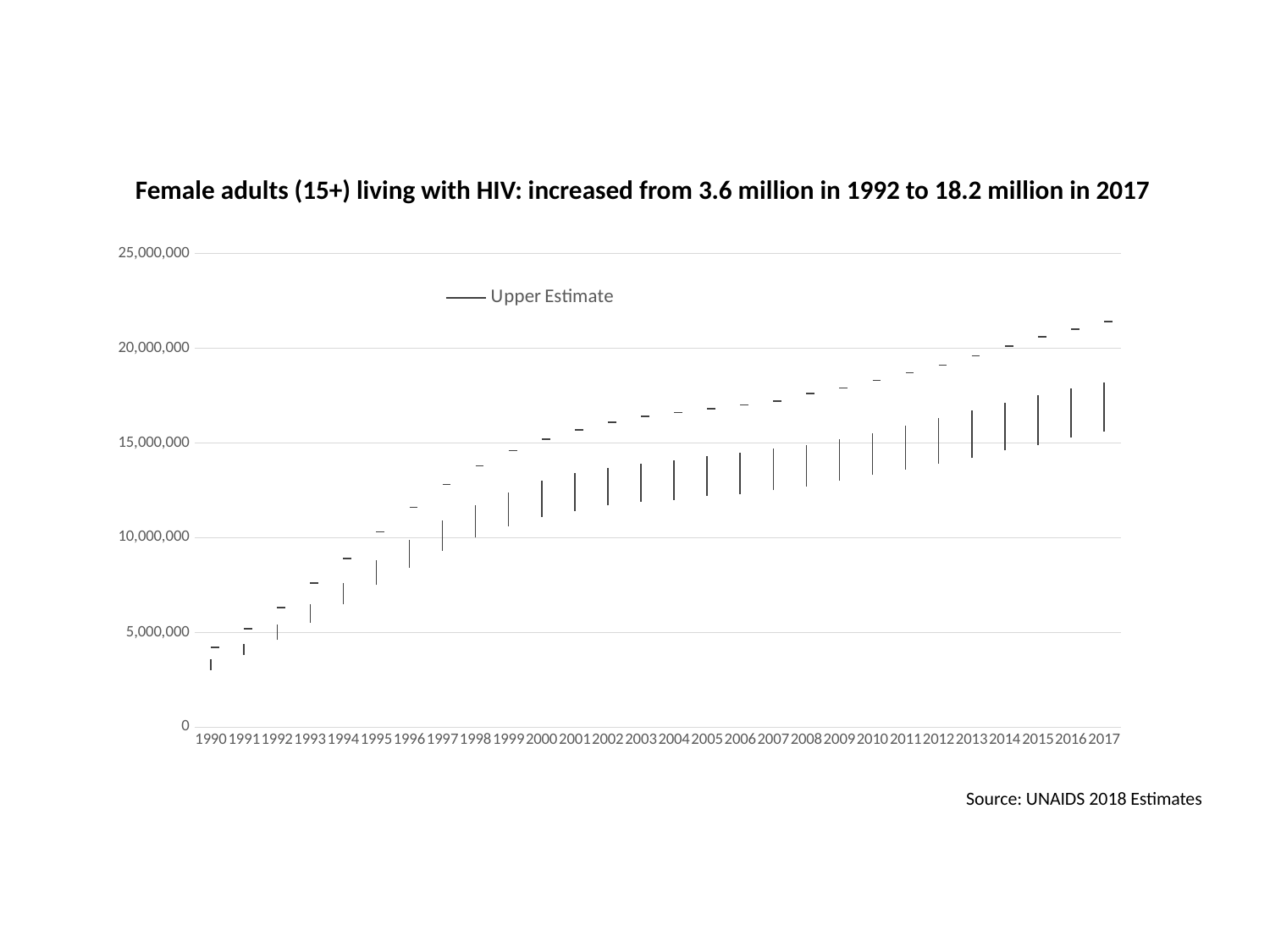
Is the Upper Estimate for 2005 greater or less than 15,000,000? greater How many years are shown along the x axis? 28 Is the Upper Estimate for 1990 greater or less than 5,000,000? less Is the Upper Estimate for 2017 greater or less than 20,000,000? greater What is the title of the chart? Female adults (15+) living with HIV: increased from 3.6 million in 1992 to 18.2 million in 2017 According to the chart title, how many female adults (15+) were living with HIV in 2017? 18.2 million What is the name of the series shown in the legend? Upper Estimate Do the Upper Estimate values rise or fall from 1990 to 2017? rise According to the chart title, how many female adults (15+) were living with HIV in 1992? 3.6 million How many series does the chart legend list? 1 Which year has the highest Upper Estimate? 2017